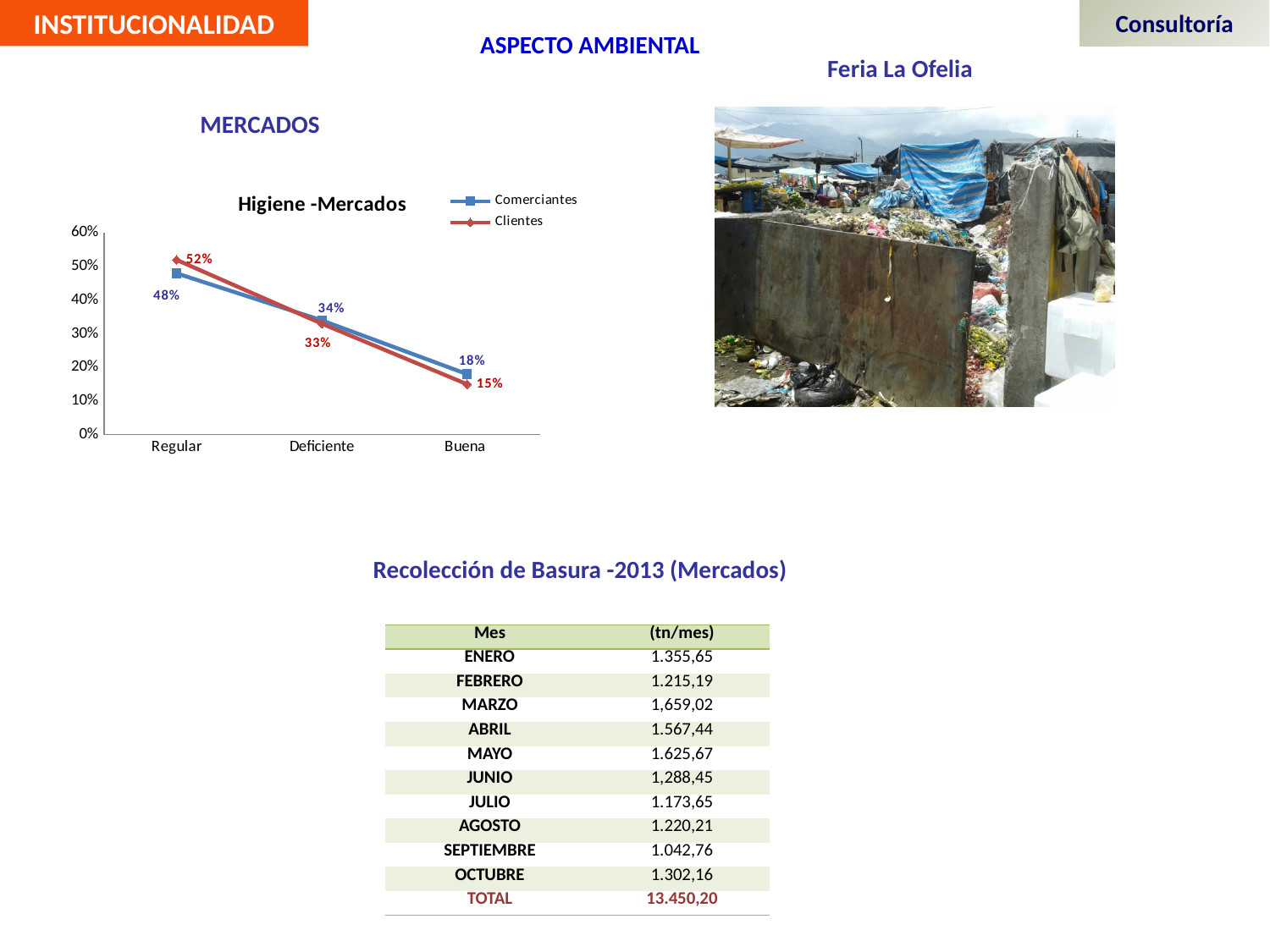
In the 'Higiene -Mercados' chart, what is the difference between the Clientes and Comerciantes values at Regular? 4% In the 'Higiene -Mercados' chart, which category has the highest value for Clientes? Regular How many categories are shown on the x axis of the 'Higiene -Mercados' chart? 3 In the 'Higiene -Mercados' chart, what is the value for Comerciantes at Deficiente? 34% In the 'Higiene -Mercados' chart, do the Comerciantes values rise or fall from Regular to Buena? Fall In the 'Higiene -Mercados' chart, what is the value for Comerciantes at Regular? 48% What kind of chart is 'Higiene -Mercados'? Line chart In the 'Higiene -Mercados' chart, which series has the larger value at Buena, Comerciantes or Clientes? Comerciantes In the 'Higiene -Mercados' chart, what is the value for Clientes at Buena? 15% In the 'Higiene -Mercados' chart, what is the value for Clientes at Regular? 52% How many series does the legend of the 'Higiene -Mercados' chart list? 2 In the 'Higiene -Mercados' chart, which category has the lowest value for Comerciantes? Buena